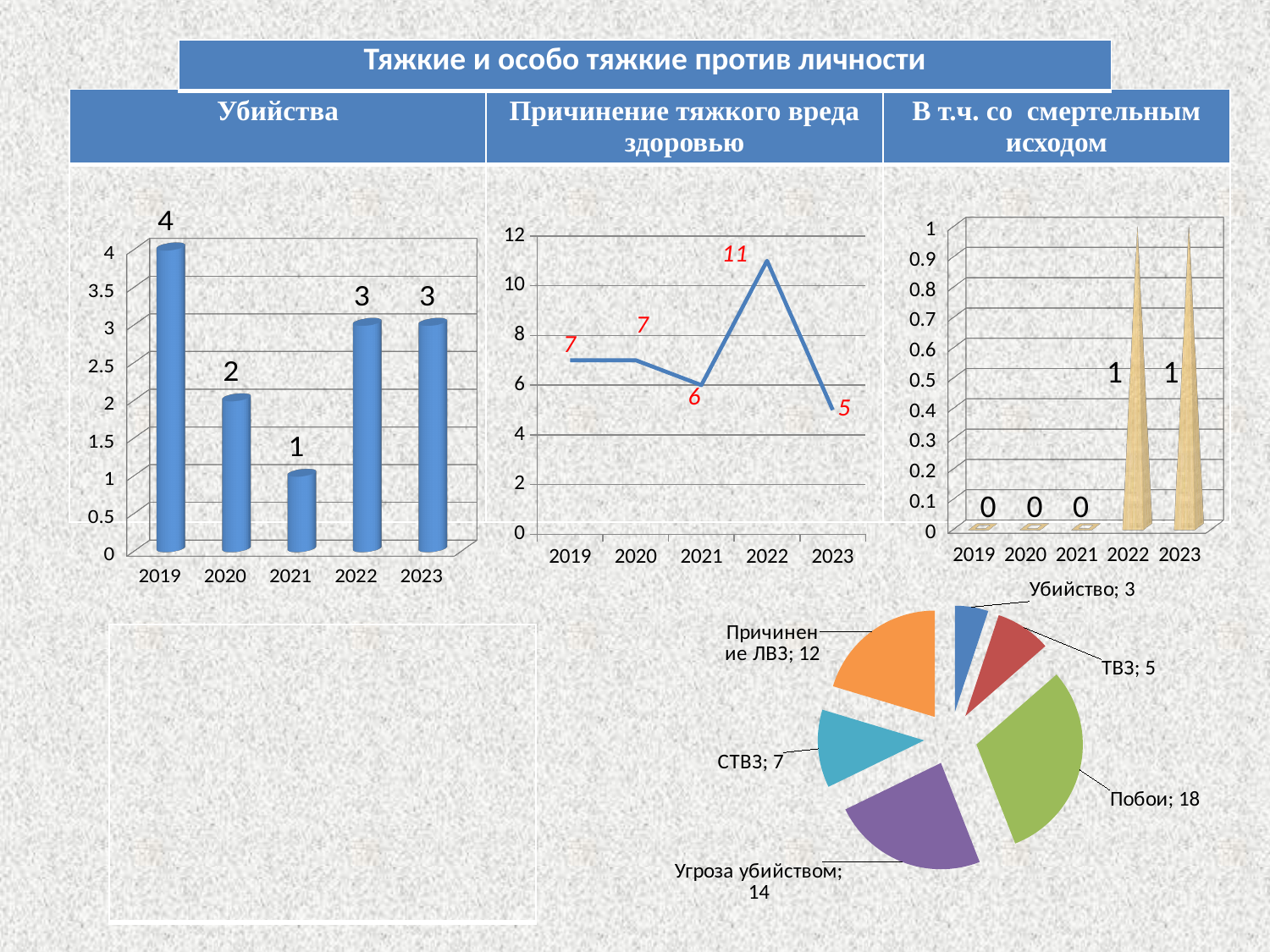
In the 'Причинение тяжкого вреда здоровью' chart, is the value for 2022 larger than the value for 2023? Yes In the 'В т.ч. со смертельным исходом' chart, what is the value for 2021? 0 In the 'Причинение тяжкого вреда здоровью' chart, what is the value for 2022? 11 In the 'Причинение тяжкого вреда здоровью' chart, which year has the highest value? 2022 In the 'Убийства' chart, what is the difference between the values for 2019 and 2020? 2 In the pie chart at the bottom of the slide, which category has the smallest value? Убийство What kind of chart is the 'Причинение тяжкого вреда здоровью' chart? line chart How many years are shown on the x axis of the 'В т.ч. со смертельным исходом' chart? 5 What kind of chart is the 'Убийства' chart? bar chart In the 'Убийства' chart, what is the value for 2019? 4 In the 'Убийства' chart, which year has the lowest value? 2021 In the pie chart at the bottom of the slide, what is the value for 'Побои'? 18